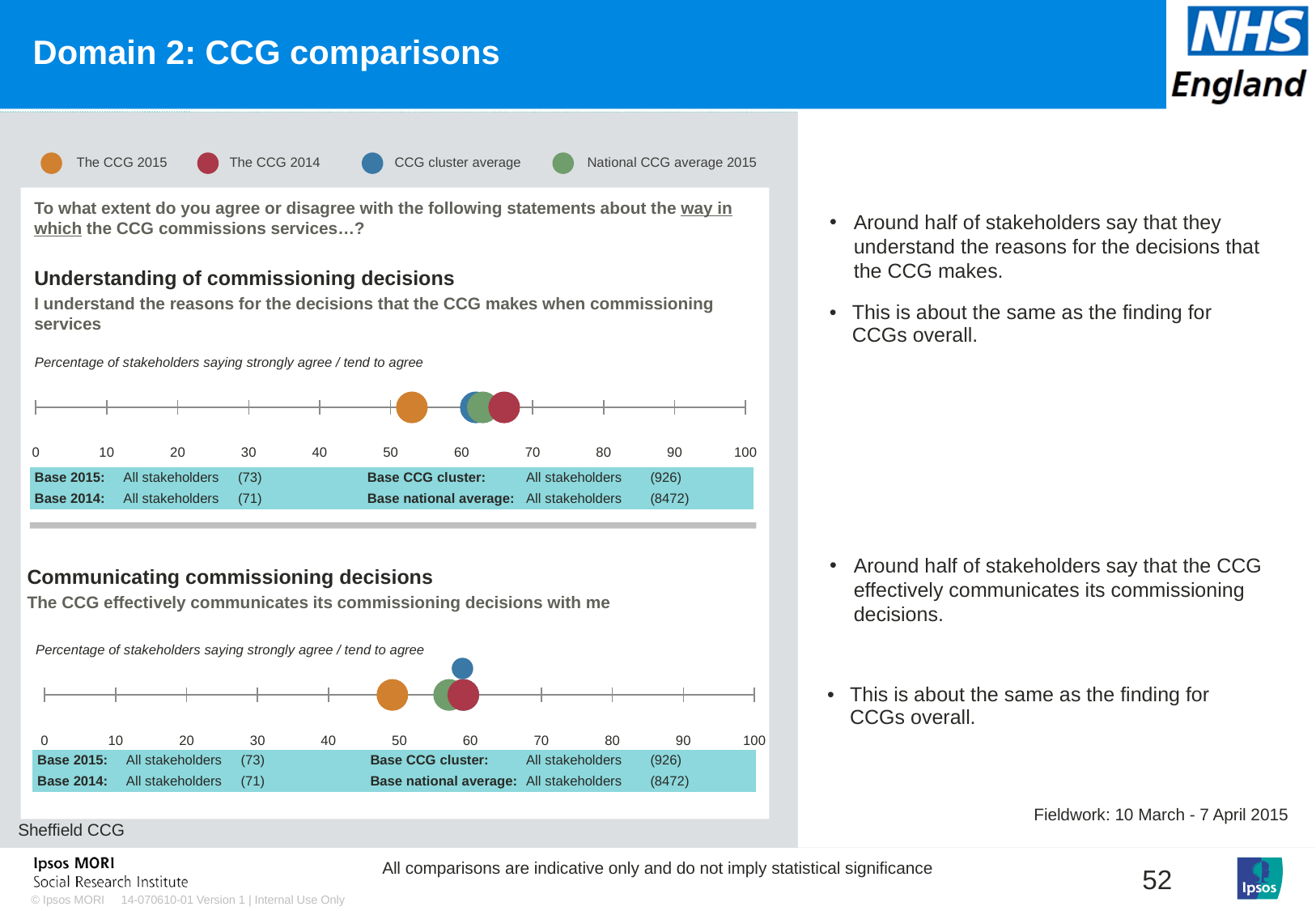
In the 'Understanding of commissioning decisions' chart, is the value for The CCG 2014 greater or less than 60? greater In the 'Communicating commissioning decisions' chart, which is larger: the value for The CCG 2015 or the value for The CCG 2014? The CCG 2014 In the 'Understanding of commissioning decisions' chart, is the value for The CCG 2015 greater or less than 60? less In the 'Communicating commissioning decisions' chart, which series has the lowest value? The CCG 2015 In the 'Communicating commissioning decisions' chart, is the value for The CCG 2015 greater or less than 60? less In the 'Understanding of commissioning decisions' chart, which is larger: the value for The CCG 2015 or the value for The CCG 2014? The CCG 2014 What is the maximum value shown on the x axis of the 'Understanding of commissioning decisions' chart? 100 What colour marks 'The CCG 2015' in the legend? Orange In the 'Understanding of commissioning decisions' chart, which is larger: the value for The CCG 2015 or the CCG cluster average? CCG cluster average In the 'Understanding of commissioning decisions' chart, which series has the lowest value? The CCG 2015 How many series does the legend list for the charts on this slide? 4